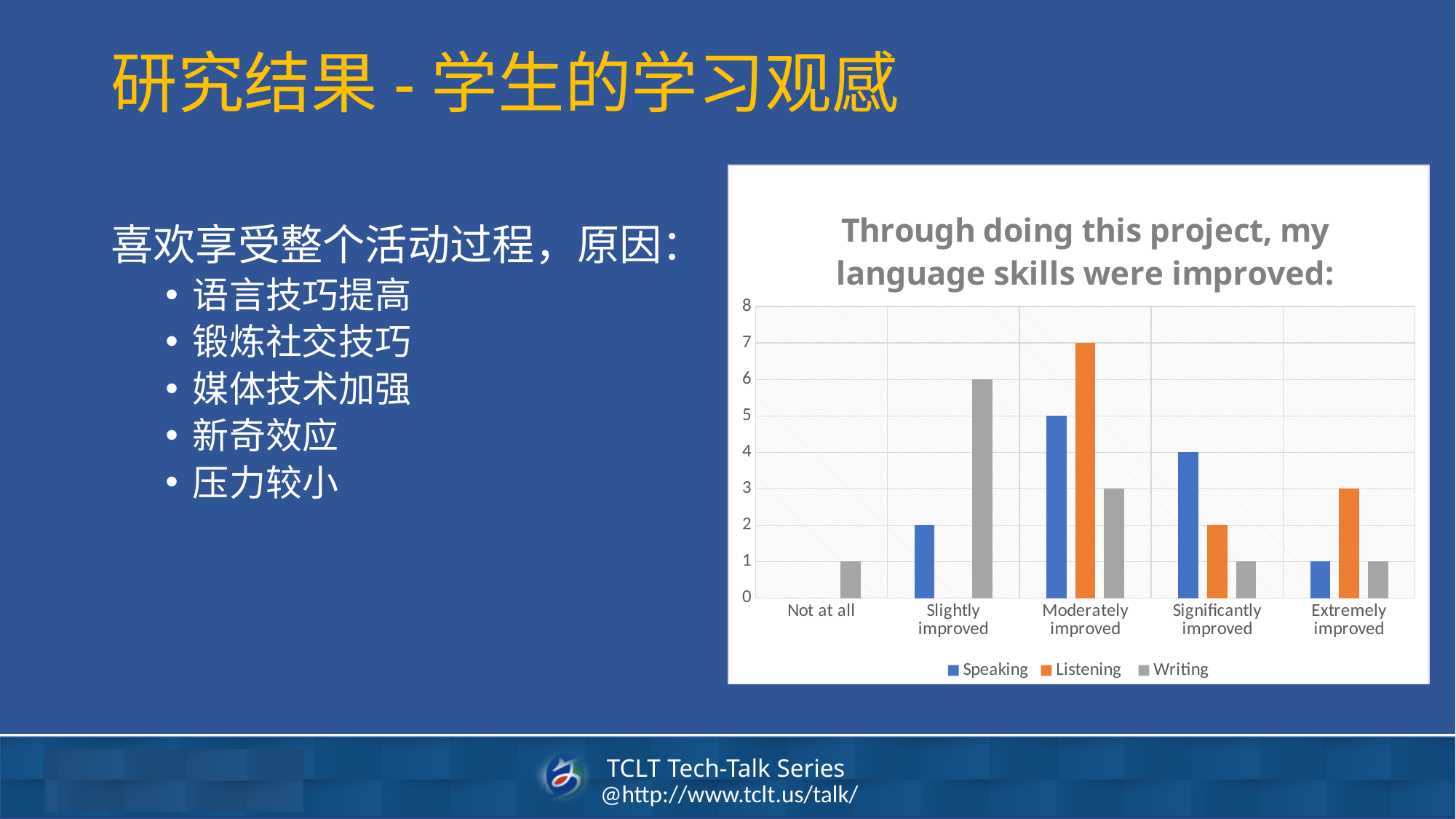
How many series does the legend list? 3 What is the value for Writing in the Slightly improved category? 6 In the Extremely improved category, which is larger, Listening or Speaking? Listening What is the title of the chart? Through doing this project, my language skills were improved: What kind of chart is shown on the slide? Bar chart What is the difference between the Listening and Speaking values in the Moderately improved category? 2 Which category has the highest Writing value? Slightly improved What is the value for Speaking in the Significantly improved category? 4 Which category has the highest Speaking value? Moderately improved How many categories are shown on the x axis? 5 What is the value for Listening in the Moderately improved category? 7 Is the value for Writing in the Moderately improved category greater or less than 4? less